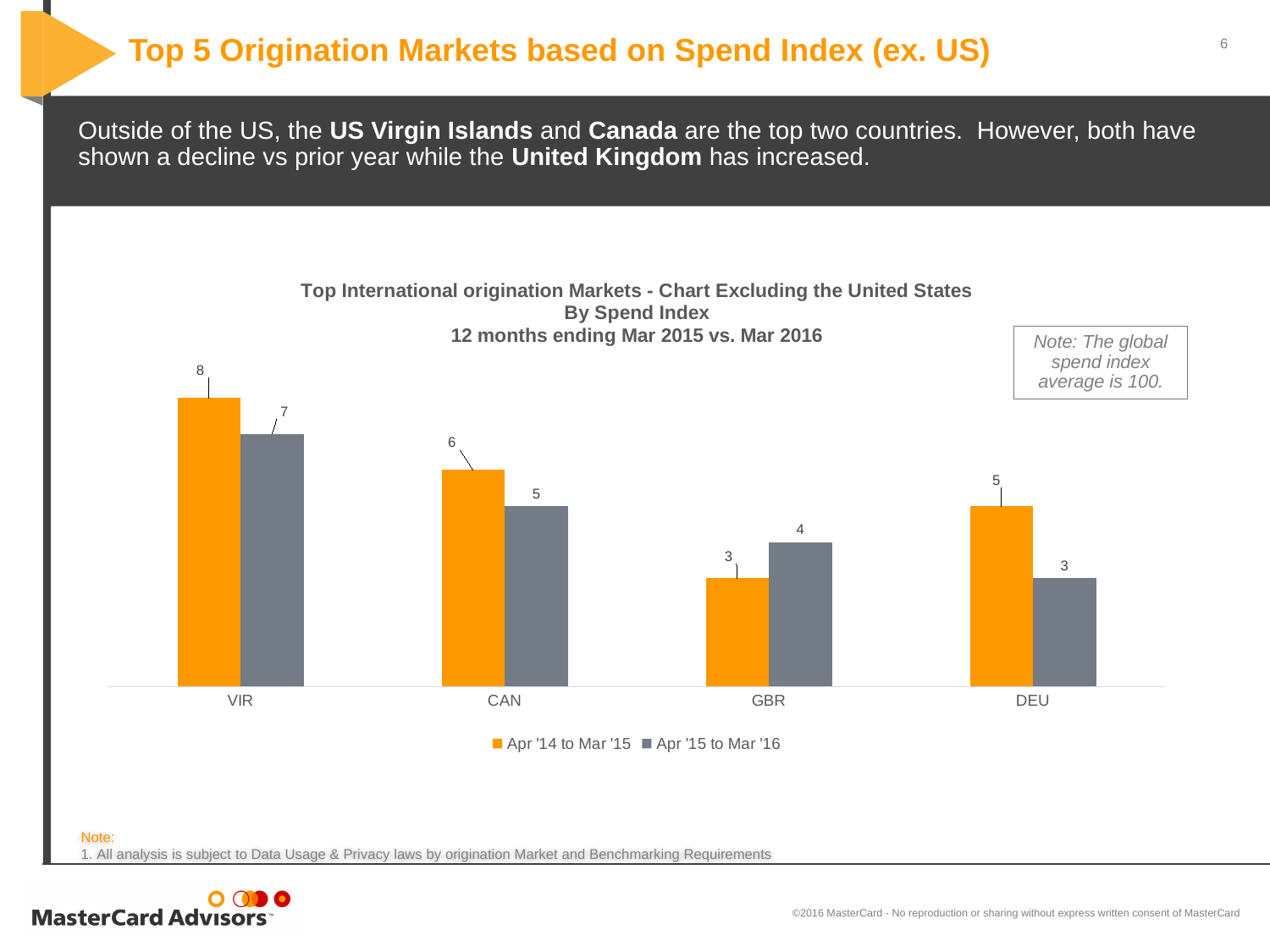
What is the value for DEU in the Apr '14 to Mar '15 series? 5 What is the value for GBR in the Apr '15 to Mar '16 series? 4 How many markets are shown on the x axis? 4 What is the difference between the Apr '14 to Mar '15 and Apr '15 to Mar '16 values for DEU? 2 What kind of chart is shown on the slide? Bar chart Which colour represents the Apr '15 to Mar '16 series? Grey What is the value for VIR in the Apr '14 to Mar '15 series? 8 For GBR, which series has the larger value: Apr '14 to Mar '15 or Apr '15 to Mar '16? Apr '15 to Mar '16 Which market has the lowest value in the Apr '14 to Mar '15 series? GBR How many series does the legend list? 2 Which market has the highest value in the Apr '15 to Mar '16 series? VIR What is the difference between the CAN values for Apr '14 to Mar '15 and Apr '15 to Mar '16? 1